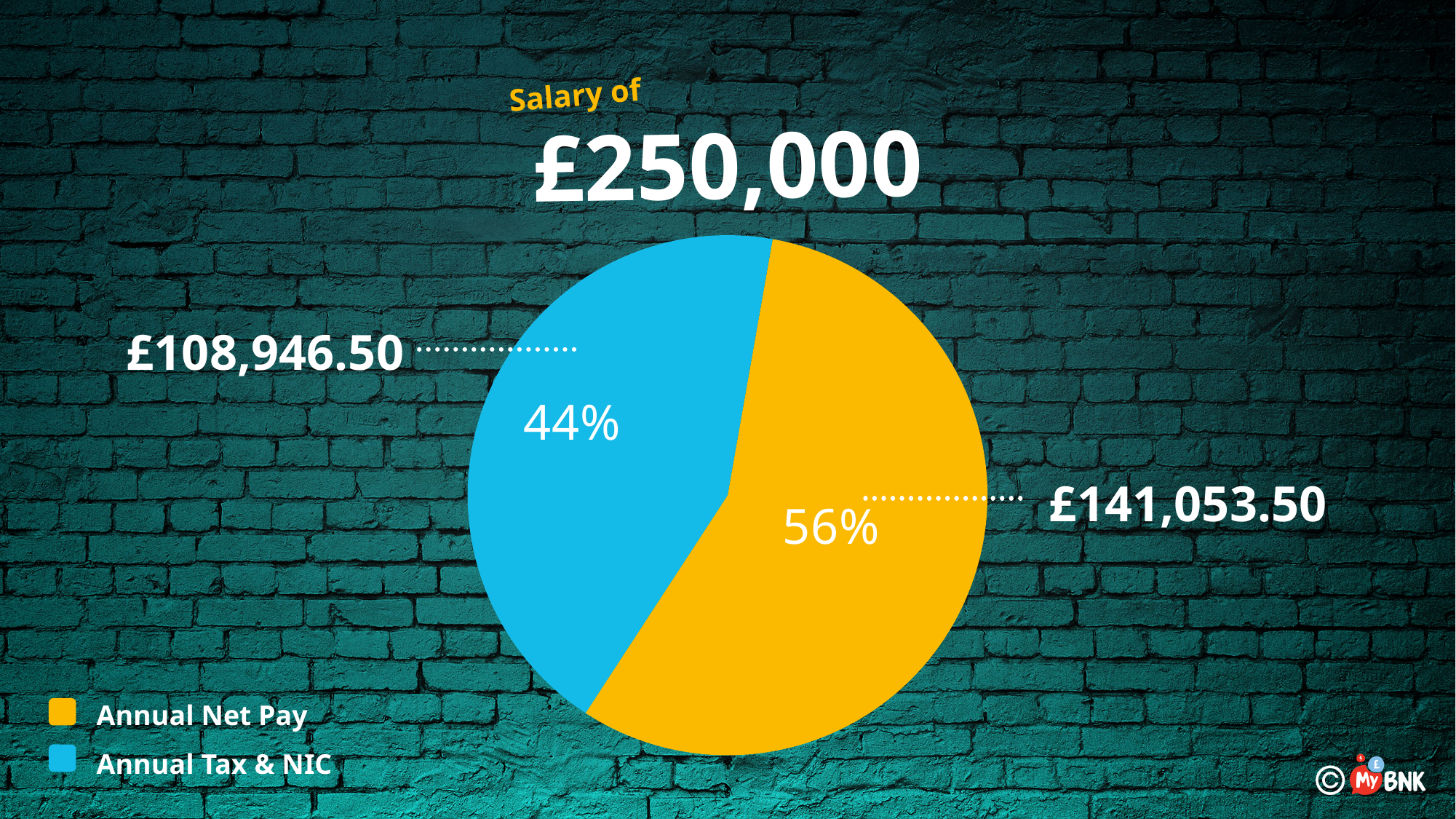
What share of the pie is Annual Tax & NIC? 44% What kind of chart is shown on the slide? pie chart How many slices does the pie chart have? 2 What share of the pie is Annual Net Pay? 56% Which is larger, Annual Net Pay or Annual Tax & NIC? Annual Net Pay What is the value for Annual Net Pay? £141,053.50 How many entries does the legend list? 2 What is the difference between Annual Net Pay and Annual Tax & NIC? £32,107.00 Which slice is the largest? Annual Net Pay What salary is the chart based on, according to the title? £250,000 Which slice is the smallest? Annual Tax & NIC What is the value for Annual Tax & NIC? £108,946.50